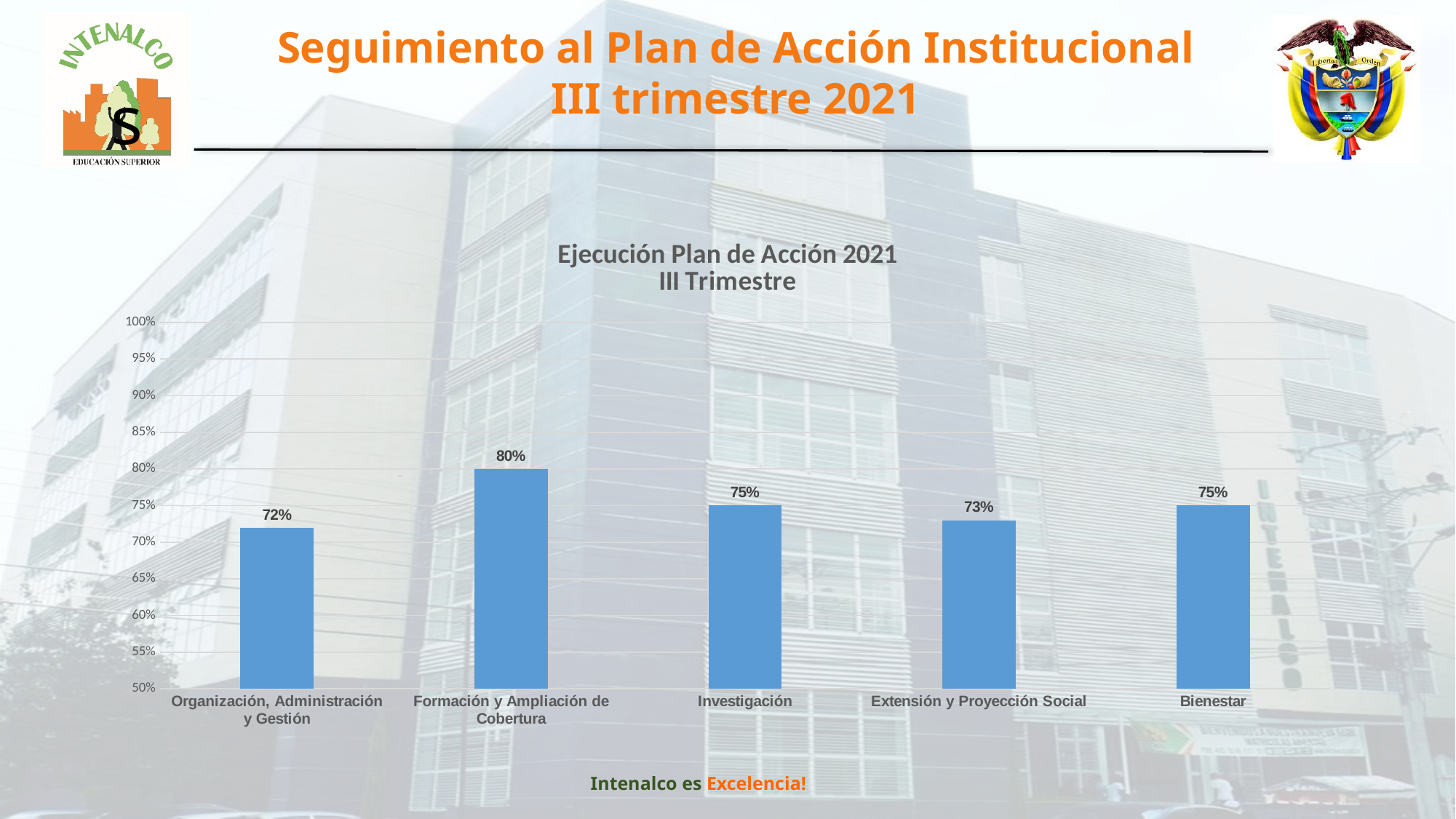
What is the value for Formación y Ampliación de Cobertura? 80% What is the value for Bienestar? 75% Which category has the lowest value? Organización, Administración y Gestión How many categories are shown in the chart? 5 What kind of chart is shown on the slide? bar chart What is the title of the chart? Ejecución Plan de Acción 2021 III Trimestre Is the value for Bienestar greater or less than 70%? greater What is the value for Extensión y Proyección Social? 73% What is the value for Organización, Administración y Gestión? 72% Which is larger, the value for Investigación or the value for Extensión y Proyección Social? Investigación Which category has the highest value? Formación y Ampliación de Cobertura What is the difference between the values for Formación y Ampliación de Cobertura and Organización, Administración y Gestión? 8%